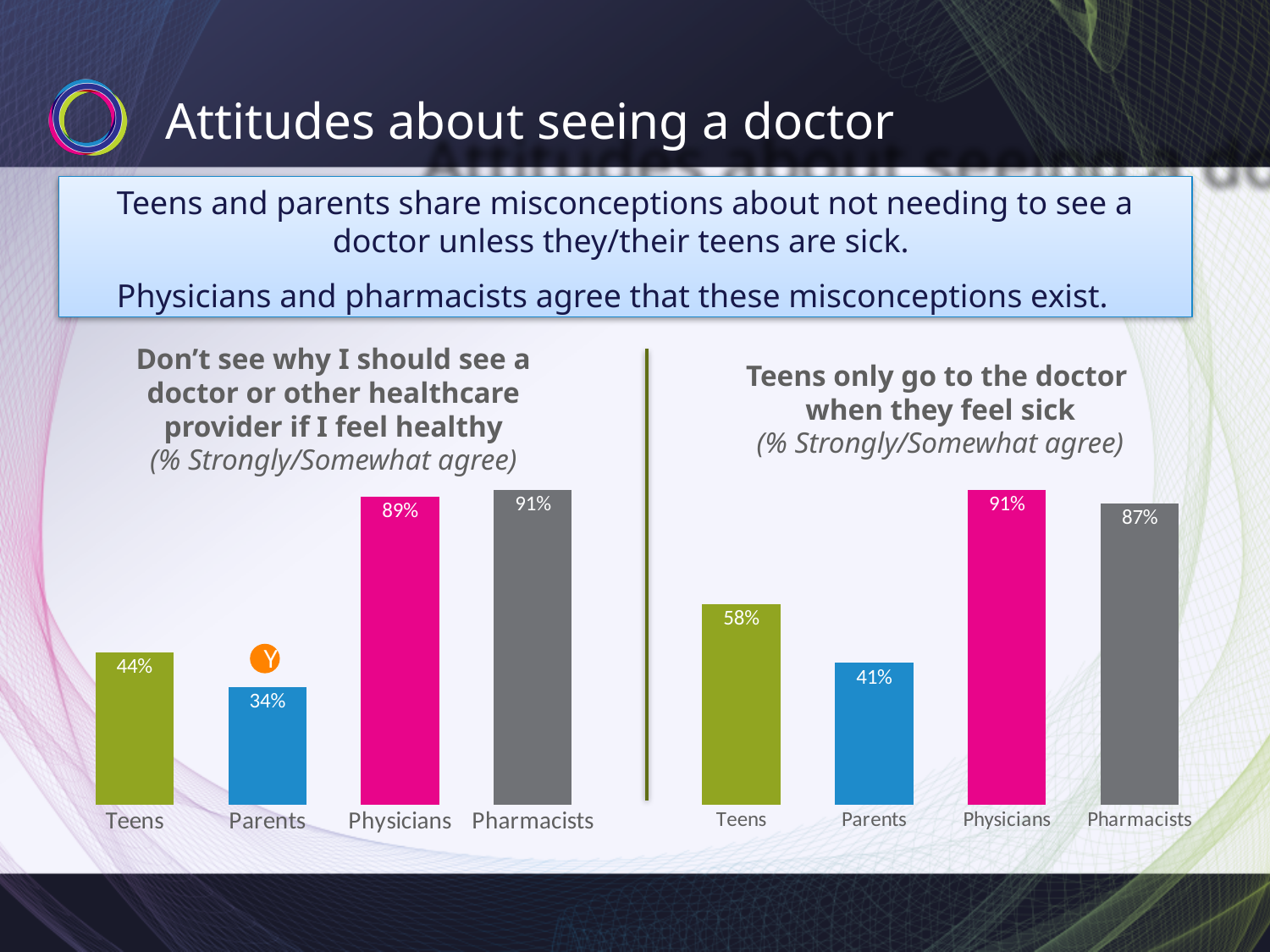
In the left chart ('Don't see why I should see a doctor or other healthcare provider if I feel healthy'), what is the value for Teens? 44% In the right chart ('Teens only go to the doctor when they feel sick'), what is the difference between the values for Teens and Parents? 17% In the left chart ('Don't see why I should see a doctor or other healthcare provider if I feel healthy'), what colour is the Physicians bar? Pink In the left chart ('Don't see why I should see a doctor or other healthcare provider if I feel healthy'), which category has the highest value? Pharmacists In the right chart ('Teens only go to the doctor when they feel sick'), which category has the lowest value? Parents In the left chart ('Don't see why I should see a doctor or other healthcare provider if I feel healthy'), what is the difference between the values for Physicians and Teens? 45% How many categories are shown in the left chart ('Don't see why I should see a doctor or other healthcare provider if I feel healthy')? 4 What kind of chart is the right chart ('Teens only go to the doctor when they feel sick')? Bar chart In the right chart ('Teens only go to the doctor when they feel sick'), which is larger, the value for Physicians or the value for Pharmacists? Physicians In the right chart ('Teens only go to the doctor when they feel sick'), what is the value for Physicians? 91% In the left chart ('Don't see why I should see a doctor or other healthcare provider if I feel healthy'), what is the value for Parents? 34% In the right chart ('Teens only go to the doctor when they feel sick'), what is the value for Pharmacists? 87%